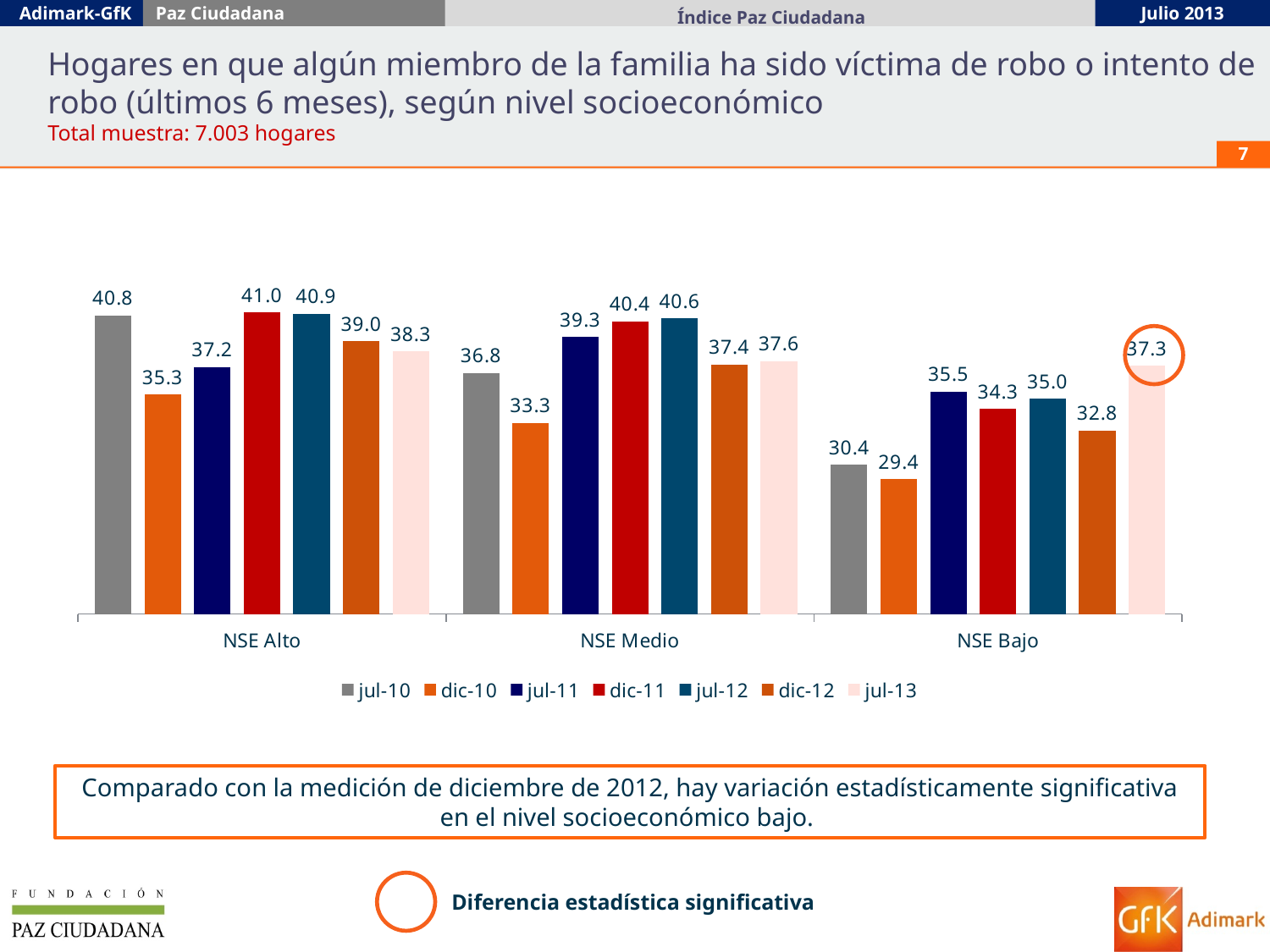
What is the difference between the jul-13 and dic-12 values in the NSE Bajo group? 4.5 What is the difference between the jul-10 values for NSE Alto and NSE Bajo? 10.4 Which series has the lowest value in the NSE Bajo group? dic-10 Which is larger: the dic-11 value for NSE Medio or the dic-11 value for NSE Bajo? NSE Medio How many series does the legend list? 7 What is the value for jul-12 in the NSE Medio group? 40.6 What is the value for jul-13 in the NSE Bajo group? 37.3 Which series has the highest value in the NSE Alto group? dic-11 Which category's jul-13 bar is circled on the chart? NSE Bajo What is the value for dic-10 in the NSE Alto group? 35.3 What kind of chart is shown on the slide? bar chart How many socioeconomic groups (categories) are shown on the x axis? 3